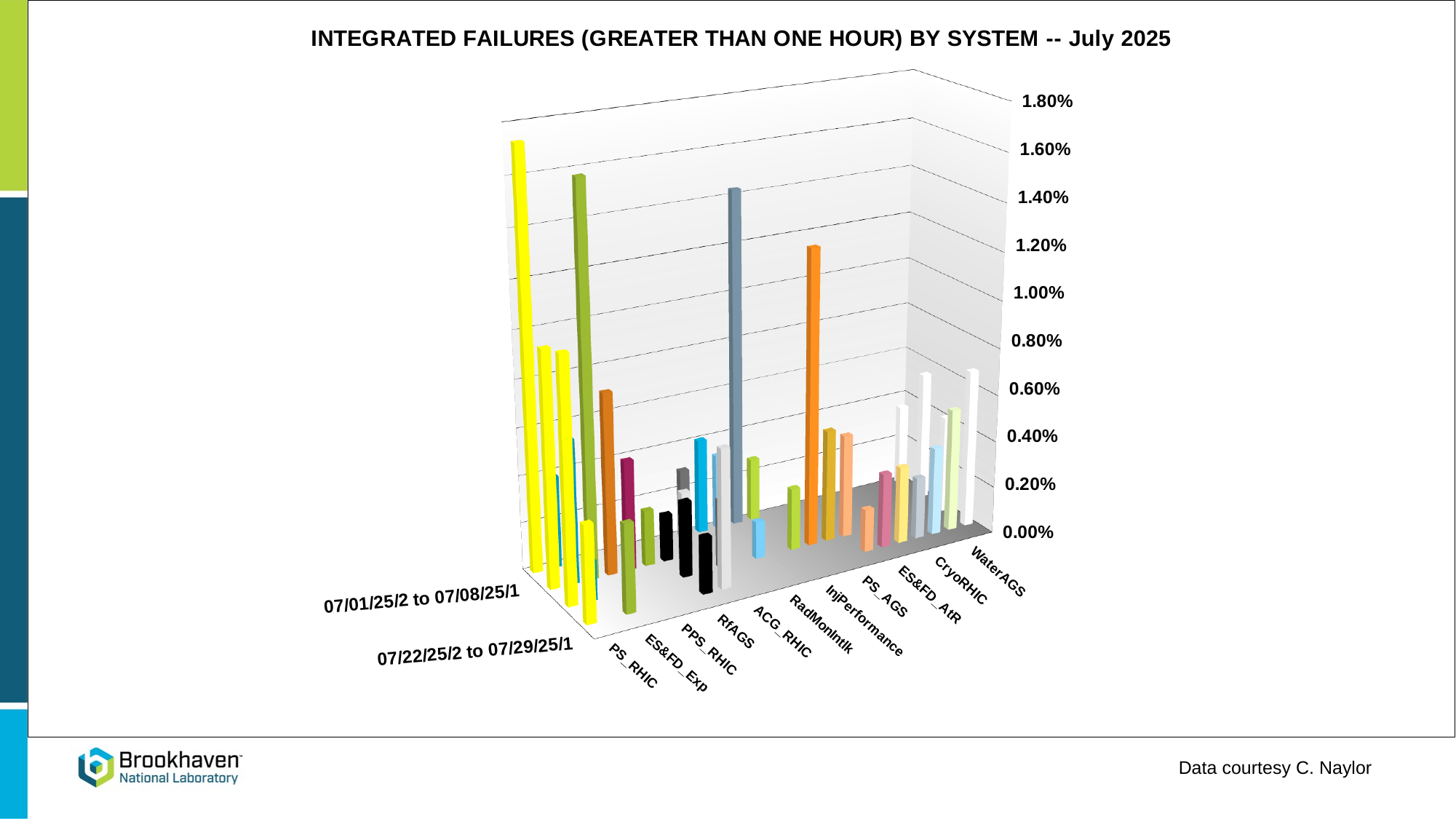
How many systems (categories) are listed along the horizontal axis of the chart? 11 Which system has the tallest bar in the chart? PS_RHIC Is the tallest bar for ACG_RHIC greater or less than 0.80%? less Is the tallest bar for PS_RHIC greater or less than 1.00%? greater Is the tallest bar for InjPerformance greater or less than 0.60%? less What is the title of the chart? INTEGRATED FAILURES (GREATER THAN ONE HOUR) BY SYSTEM -- July 2025 What is the highest value shown on the vertical axis of the chart? 1.80% Which system has a taller tallest bar, PS_RHIC or RfAGS? PS_RHIC What kind of chart is shown on the slide? bar chart